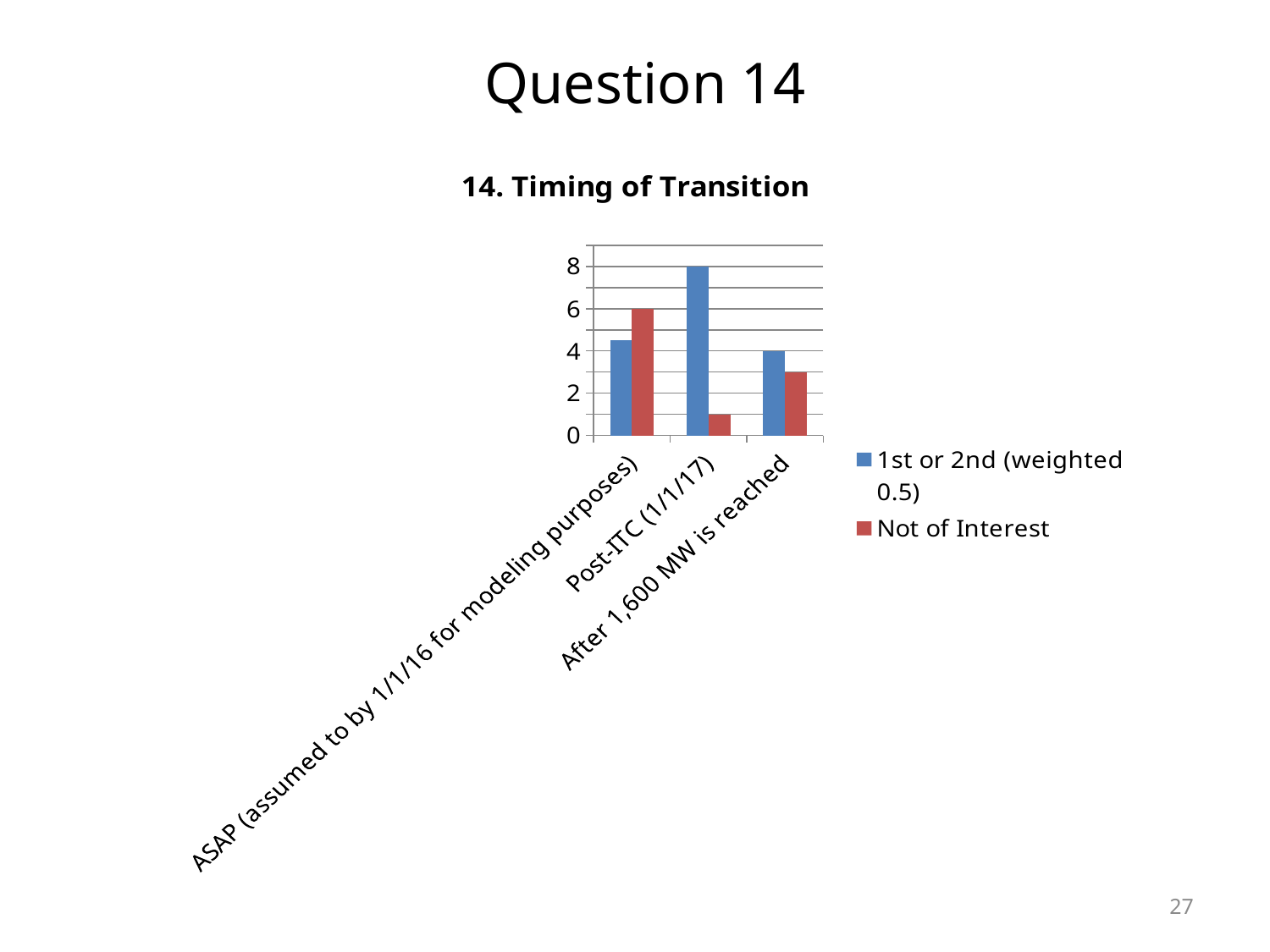
Which category has the highest value in the 1st or 2nd (weighted 0.5) series? Post-ITC (1/1/17) Is the Not of Interest value for Post-ITC (1/1/17) greater or less than 2? less Which category has the lowest Not of Interest value? Post-ITC (1/1/17) For ASAP (assumed to by 1/1/16 for modeling purposes), which series has the larger value: 1st or 2nd (weighted 0.5) or Not of Interest? Not of Interest What is the title of the chart? 14. Timing of Transition What type of chart is shown on the slide? Bar chart What is the 1st or 2nd (weighted 0.5) value for After 1,600 MW is reached? 4 What is the value for Post-ITC (1/1/17) in the 1st or 2nd (weighted 0.5) series? 8 How many categories are shown on the x axis? 3 What is the difference between the 1st or 2nd (weighted 0.5) values for Post-ITC (1/1/17) and After 1,600 MW is reached? 4 What is the Not of Interest value for ASAP (assumed to by 1/1/16 for modeling purposes)? 6 How many series does the legend list? 2